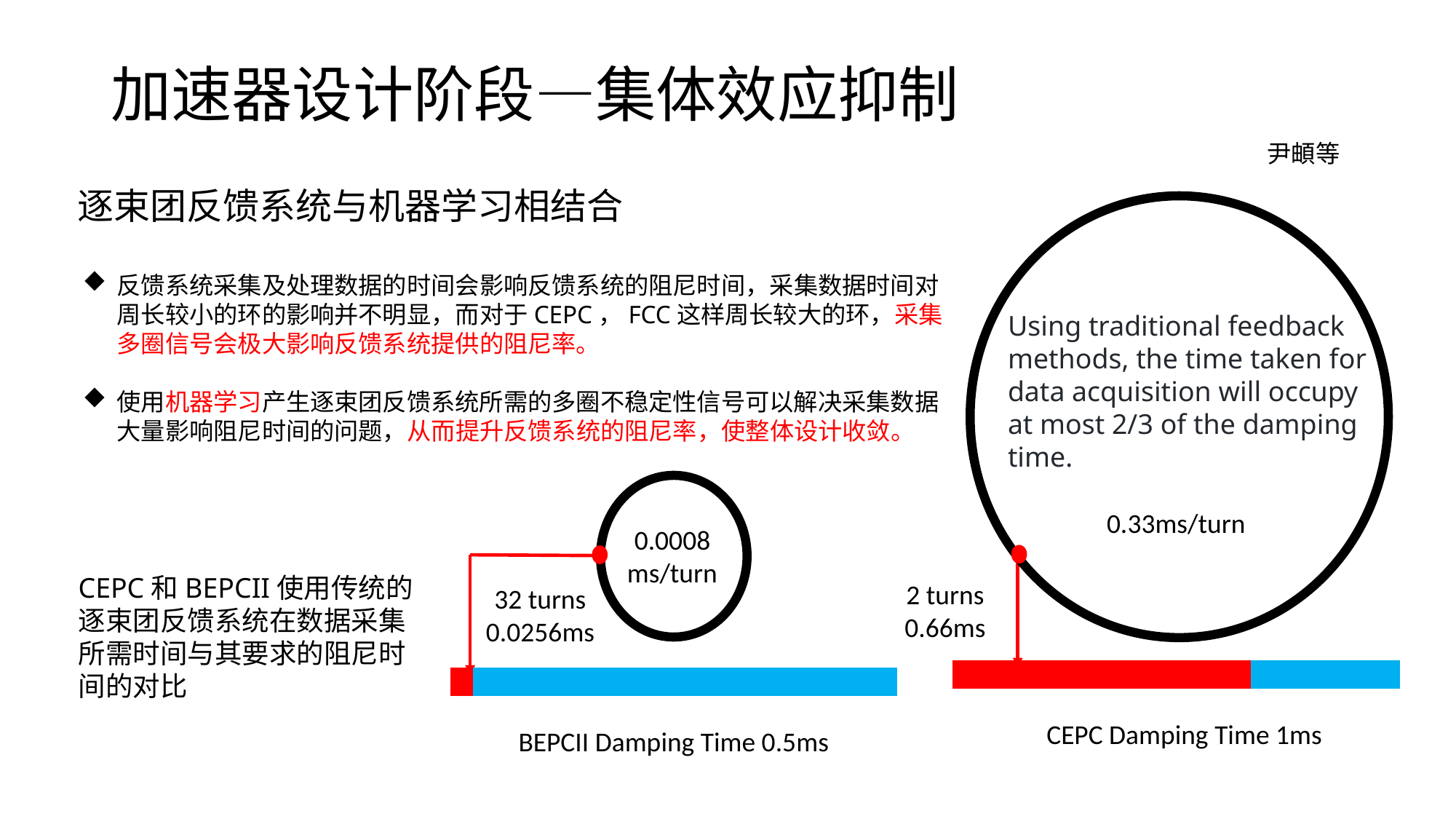
What time per turn is printed inside the large CEPC ring? 0.33ms/turn What time per turn is printed inside the small BEPCII ring? 0.0008 ms/turn In which ring's bar does the red data-acquisition portion take up a larger share of the damping-time bar, BEPCII or CEPC? CEPC What data acquisition time is labelled for CEPC in the bottom diagram? 0.66ms In the bar diagram at the bottom, what damping time is shown for CEPC? 1ms What colour is used for the data acquisition portion of the damping-time bars? Red Which ring has the longer damping time in the bottom diagram, BEPCII or CEPC? CEPC In the bar diagram at the bottom, what damping time is shown for BEPCII? 0.5ms What data acquisition time is labelled for BEPCII in the bottom diagram? 0.0256ms What is the difference between the CEPC damping time and the BEPCII damping time shown? 0.5ms How many turns of data acquisition are labelled for BEPCII in the bottom diagram? 32 turns How many turns of data acquisition are labelled for CEPC in the bottom diagram? 2 turns